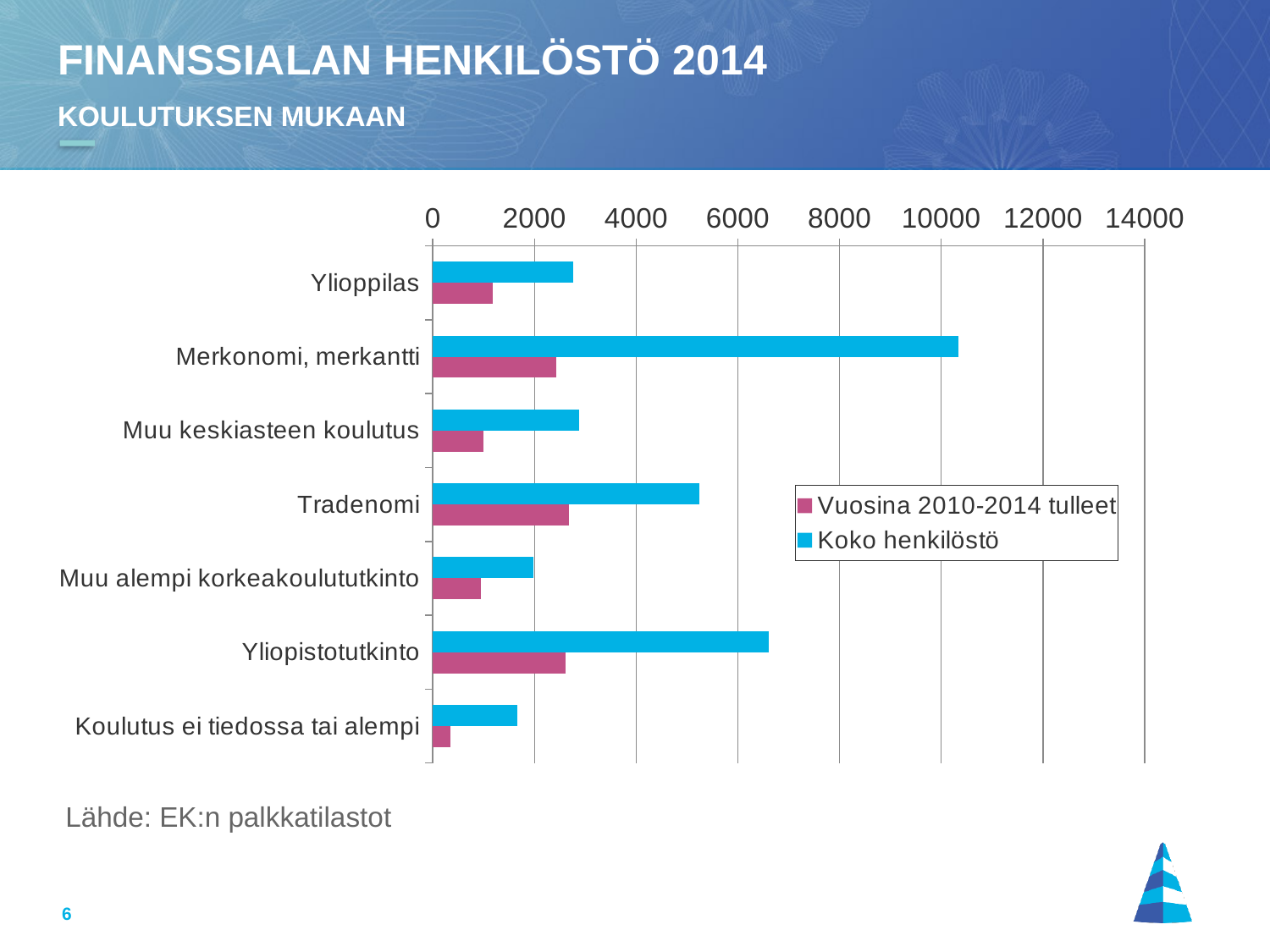
Is the Koko henkilöstö value for Yliopistotutkinto greater or less than 6000? greater Which category has the highest value for Koko henkilöstö? Merkonomi, merkantti Which is larger for Vuosina 2010-2014 tulleet: Merkonomi, merkantti or Ylioppilas? Merkonomi, merkantti Is the Koko henkilöstö value for Merkonomi, merkantti greater or less than 10000? greater Which category has the lowest value for Vuosina 2010-2014 tulleet? Koulutus ei tiedossa tai alempi What kind of chart is shown on the slide? bar chart What colour are the bars for the Koko henkilöstö series? blue Which category has the lowest value for Koko henkilöstö? Koulutus ei tiedossa tai alempi Is the Koko henkilöstö value for Koulutus ei tiedossa tai alempi greater or less than 2000? less Which is larger for Koko henkilöstö: Yliopistotutkinto or Tradenomi? Yliopistotutkinto How many series does the legend list? 2 How many education categories are shown on the chart? 7